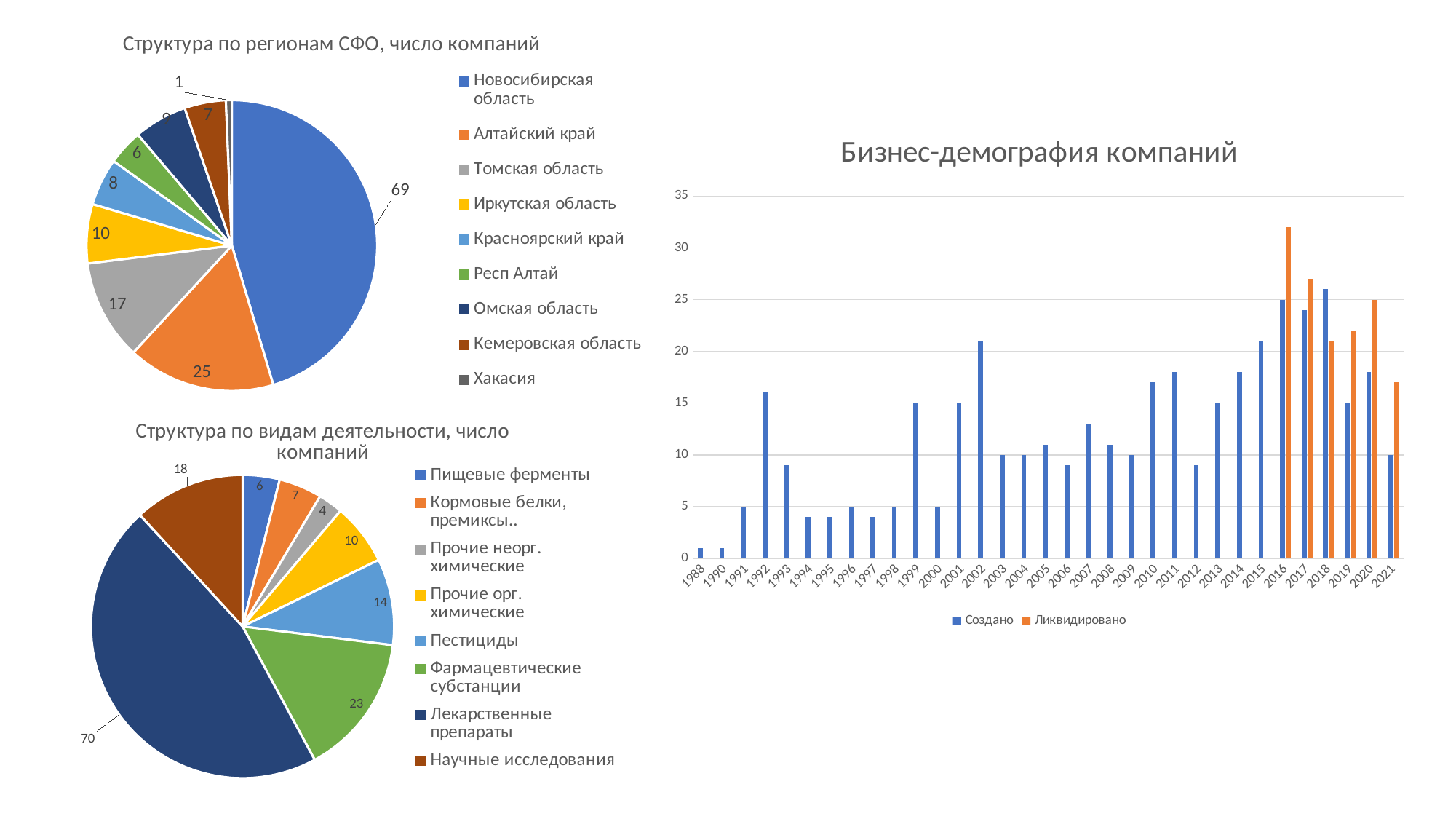
In the chart 'Бизнес-демография компаний', is the value of Создано for 1988 greater or less than 5? less In the pie chart 'Структура по видам деятельности, число компаний', which category has the largest slice? Лекарственные препараты In the chart 'Бизнес-демография компаний', is the value of Ликвидировано for 2016 greater or less than 30? greater How many series does the legend of the chart 'Бизнес-демография компаний' list? 2 In the pie chart 'Структура по регионам СФО, число компаний', what is the value for Новосибирская область? 69 How many categories does the legend of the pie chart 'Структура по регионам СФО, число компаний' list? 9 What kind of chart is 'Бизнес-демография компаний'? Bar chart In the pie chart 'Структура по регионам СФО, число компаний', which region has the smallest slice? Хакасия In the pie chart 'Структура по видам деятельности, число компаний', which is larger: Фармацевтические субстанции or Научные исследования? Фармацевтические субстанции In the pie chart 'Структура по регионам СФО, число компаний', what is the difference between Новосибирская область and Алтайский край? 44 In the chart 'Бизнес-демография компаний', which year has the tallest Ликвидировано bar? 2016 In the pie chart 'Структура по видам деятельности, число компаний', what is the value for Пестициды? 14